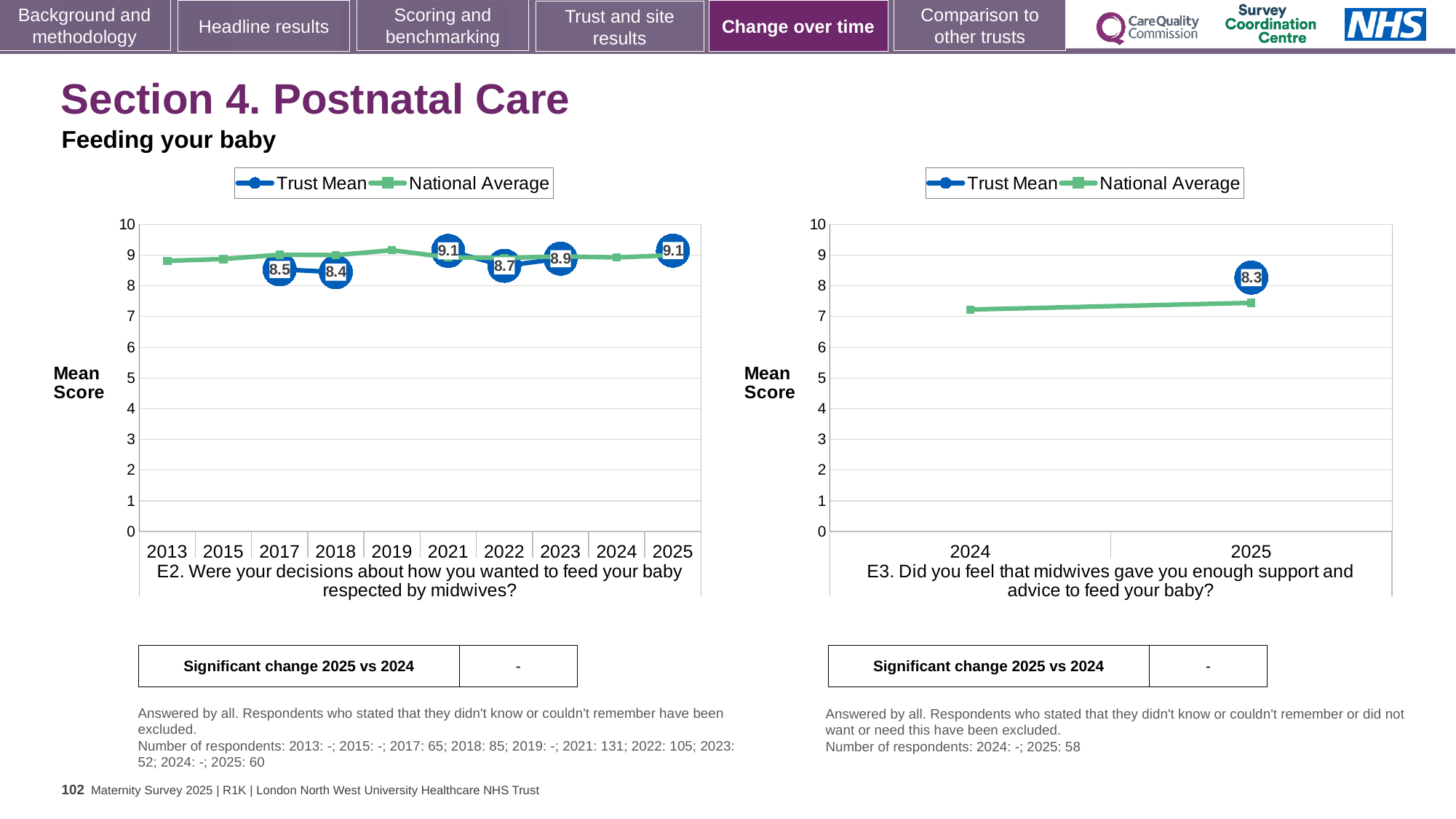
In the right chart (E3), what is the Trust Mean score for 2025? 8.3 In the left chart (E2), what is the difference between the Trust Mean scores for 2025 and 2018? 0.7 In the left chart (E2), is the National Average value for 2013 greater or less than 8? greater In the right chart (E3), is the National Average value for 2024 greater or less than 8? less In the left chart (E2), which year has the lowest labelled Trust Mean score? 2018 In the left chart (E2), what is the Trust Mean score for 2018? 8.4 How many years are shown on the x axis of the left chart (E2)? 10 How many series does the legend of the left chart (E2) list? 2 In the left chart (E2), which year has the higher Trust Mean score, 2022 or 2023? 2023 What are the two series named in the legend of the right chart (E3)? Trust Mean and National Average In the left chart (E2), what is the Trust Mean score for 2025? 9.1 What kind of chart is the right chart (E3)? Line chart